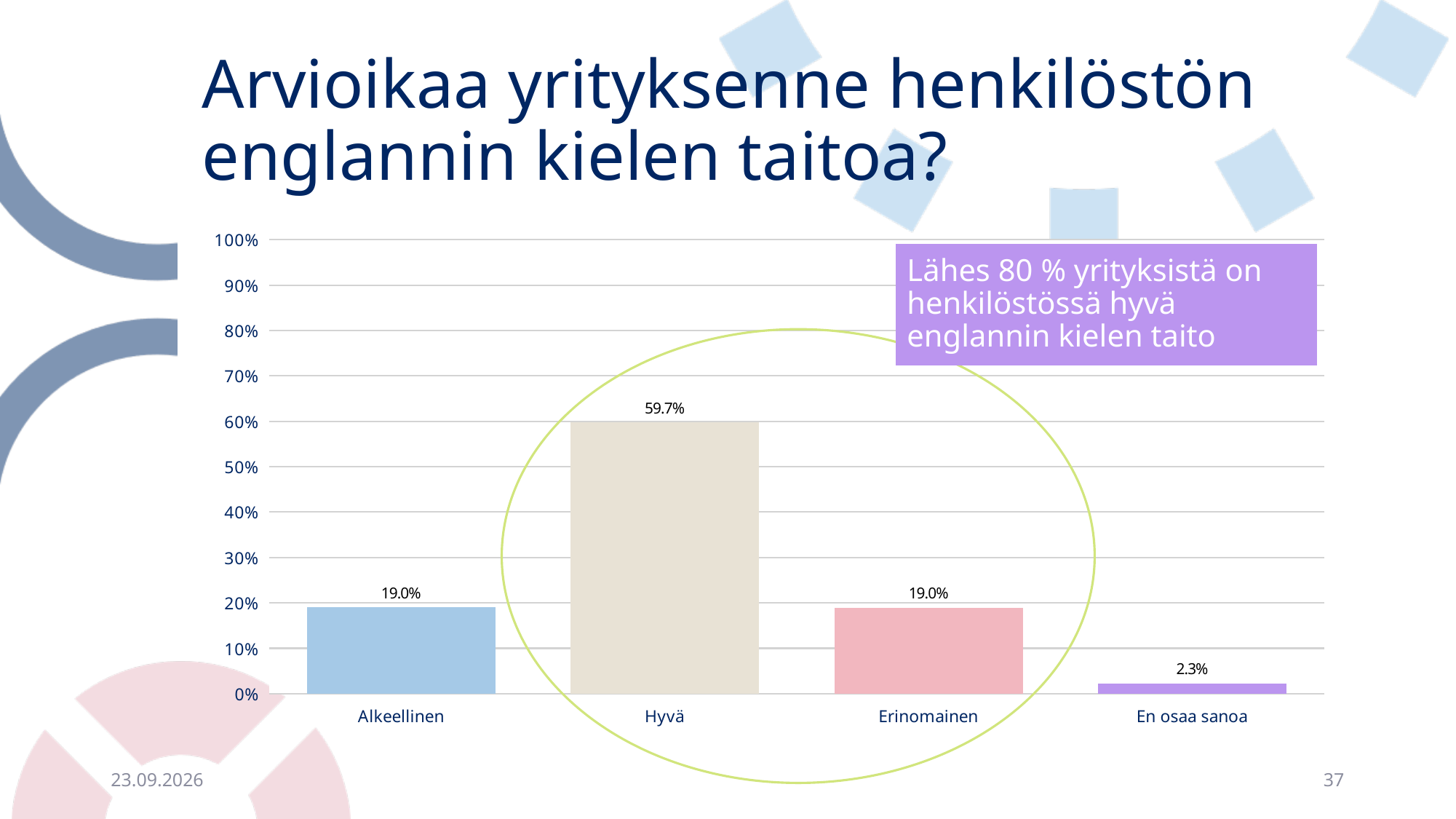
Is the value for Hyvä greater or less than 50%? greater What is the difference between the values for Hyvä and Erinomainen? 40.7% What is the difference between the values for Alkeellinen and En osaa sanoa? 16.7% What is the value for Erinomainen? 19.0% What kind of chart is shown on the slide? Bar chart What is the value for Alkeellinen? 19.0% Which category has the lowest value? En osaa sanoa What is the value for En osaa sanoa? 2.3% What is the value for Hyvä? 59.7% Which is larger, the value for Hyvä or the value for Alkeellinen? Hyvä Which category has the highest value? Hyvä How many categories are shown on the x axis? 4